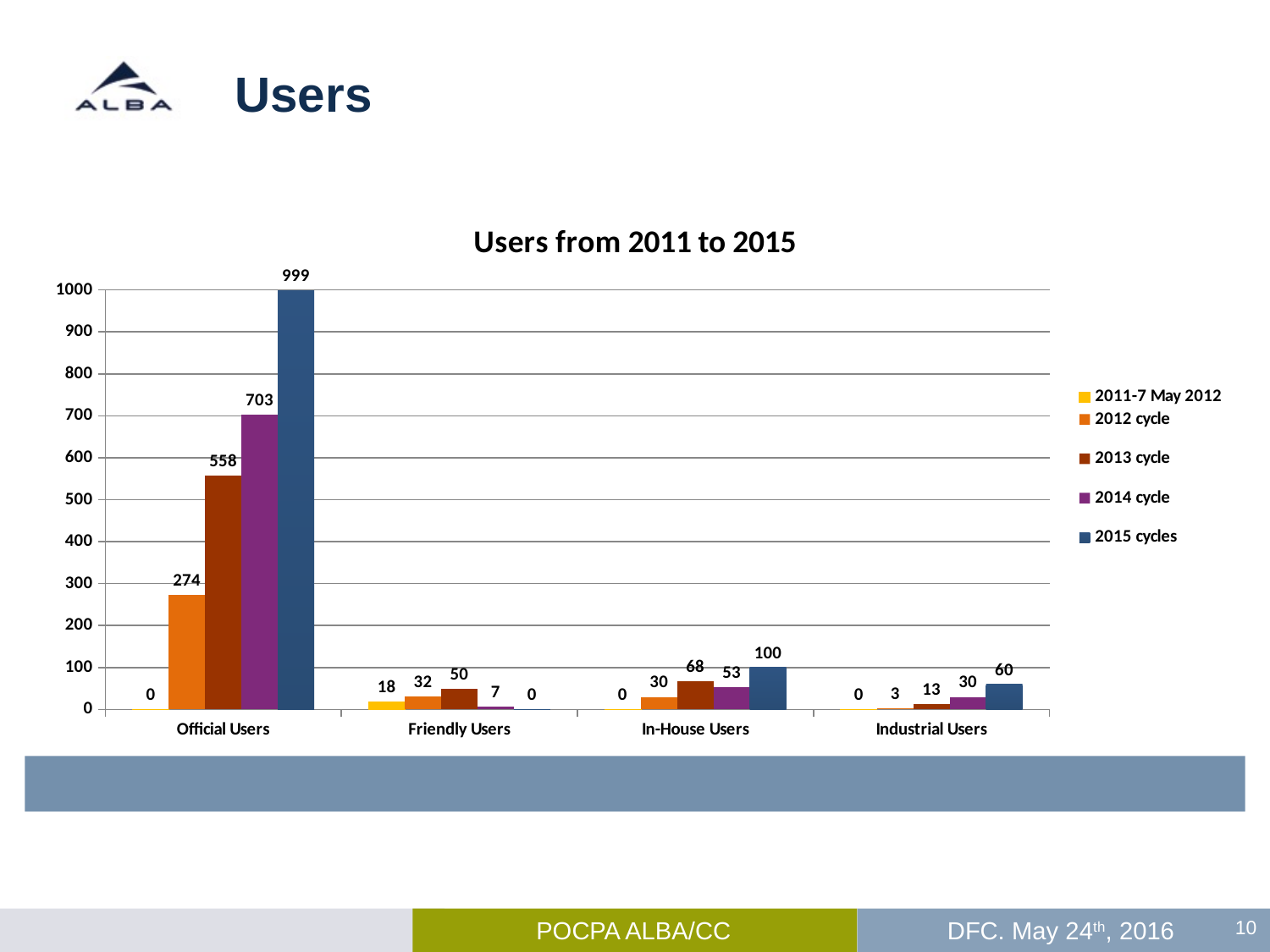
Which category has the lowest value in the 2013 cycle series? Industrial Users How many categories are shown on the x axis? 4 Which category has the highest value in the 2015 cycles series? Official Users How many series does the legend list? 5 What is the title of the chart? Users from 2011 to 2015 What kind of chart is shown on the slide? Bar chart What is the difference between the 2015 cycles and 2014 cycle values for Official Users? 296 Which is larger for In-House Users: the 2013 cycle value or the 2014 cycle value? 2013 cycle What is the value for In-House Users in the 2013 cycle series? 68 What is the value for Industrial Users in the 2012 cycle series? 3 What is the value for Official Users in the 2015 cycles series? 999 What is the value for Friendly Users in the 2014 cycle series? 7